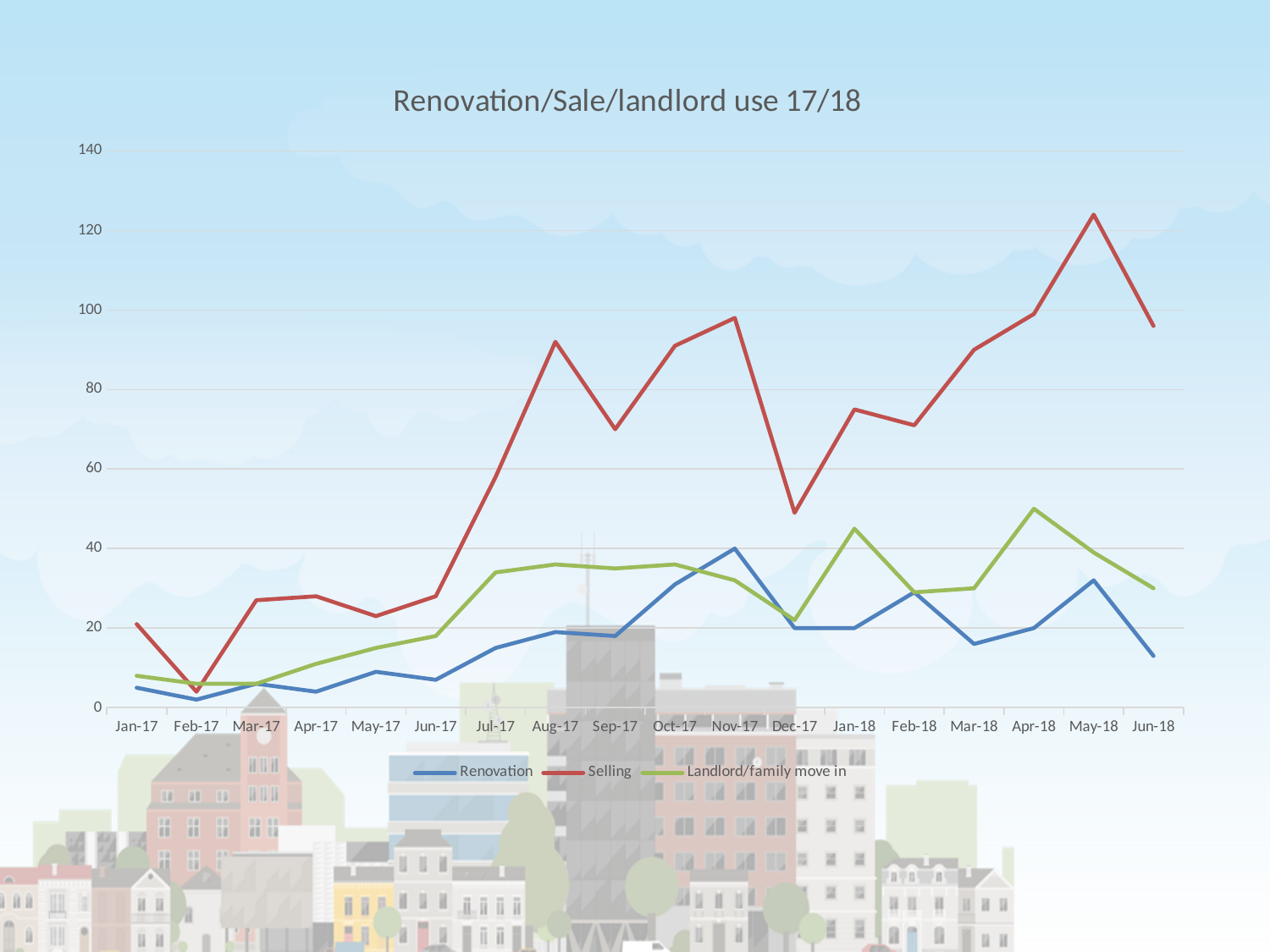
Does the Selling series generally rise or fall from Jan-17 to Jun-18? Rise How many series does the legend list? 3 Is the value for Renovation in Jun-18 greater or less than 20? less Is the value for Selling in May-18 greater or less than 120? greater What is the title of the chart? Renovation/Sale/landlord use 17/18 How many months are plotted along the x axis? 18 What kind of chart is shown on the slide? Line chart In which month does the Selling series reach its highest value? May-18 Which series has the larger value in Aug-17, Selling or Renovation? Selling Is the value for Selling in Dec-17 greater or less than 60? less In which month does the Selling series reach its lowest value? Feb-17 In which month does the Landlord/family move in series reach its highest value? Apr-18